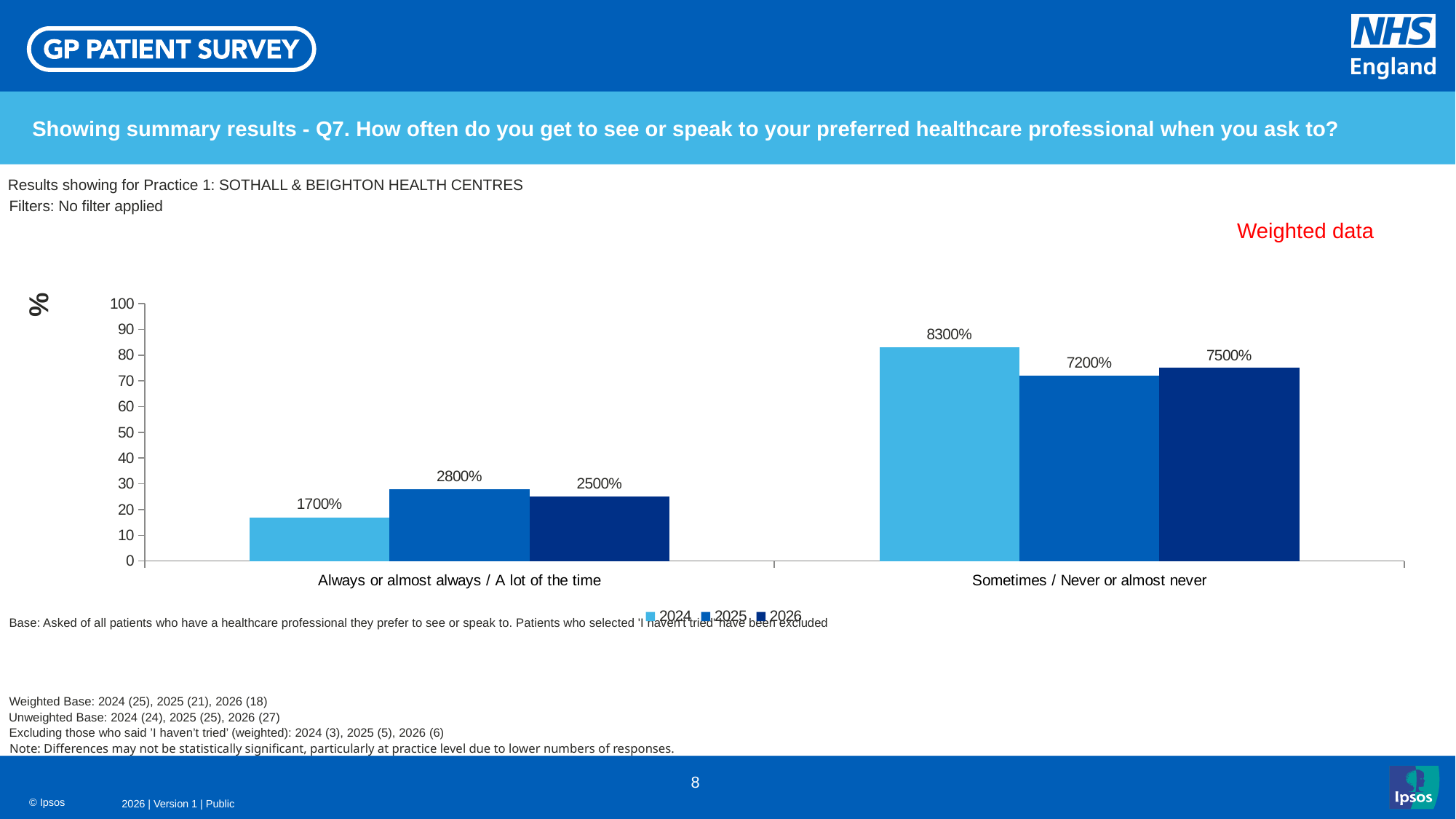
What kind of chart is shown on the slide? bar chart Is the 2025 bar for 'Always or almost always / A lot of the time' greater or less than 30 on the axis? less Which year has the lowest bar in the 'Always or almost always / A lot of the time' category? 2024 Which year has the highest bar in the 'Sometimes / Never or almost never' category? 2024 How many categories are shown on the x axis? 2 Which is larger in the 'Sometimes / Never or almost never' category: the 2025 bar or the 2026 bar? 2026 What is the data label shown for 2024 in the 'Sometimes / Never or almost never' category? 8300% What are the series names listed in the legend? 2024, 2025, 2026 What is the data label shown for 2024 in the 'Always or almost always / A lot of the time' category? 1700% What is the data label shown for 2026 in the 'Sometimes / Never or almost never' category? 7500% What is the data label shown for 2025 in the 'Always or almost always / A lot of the time' category? 2800% How many series does the legend list? 3